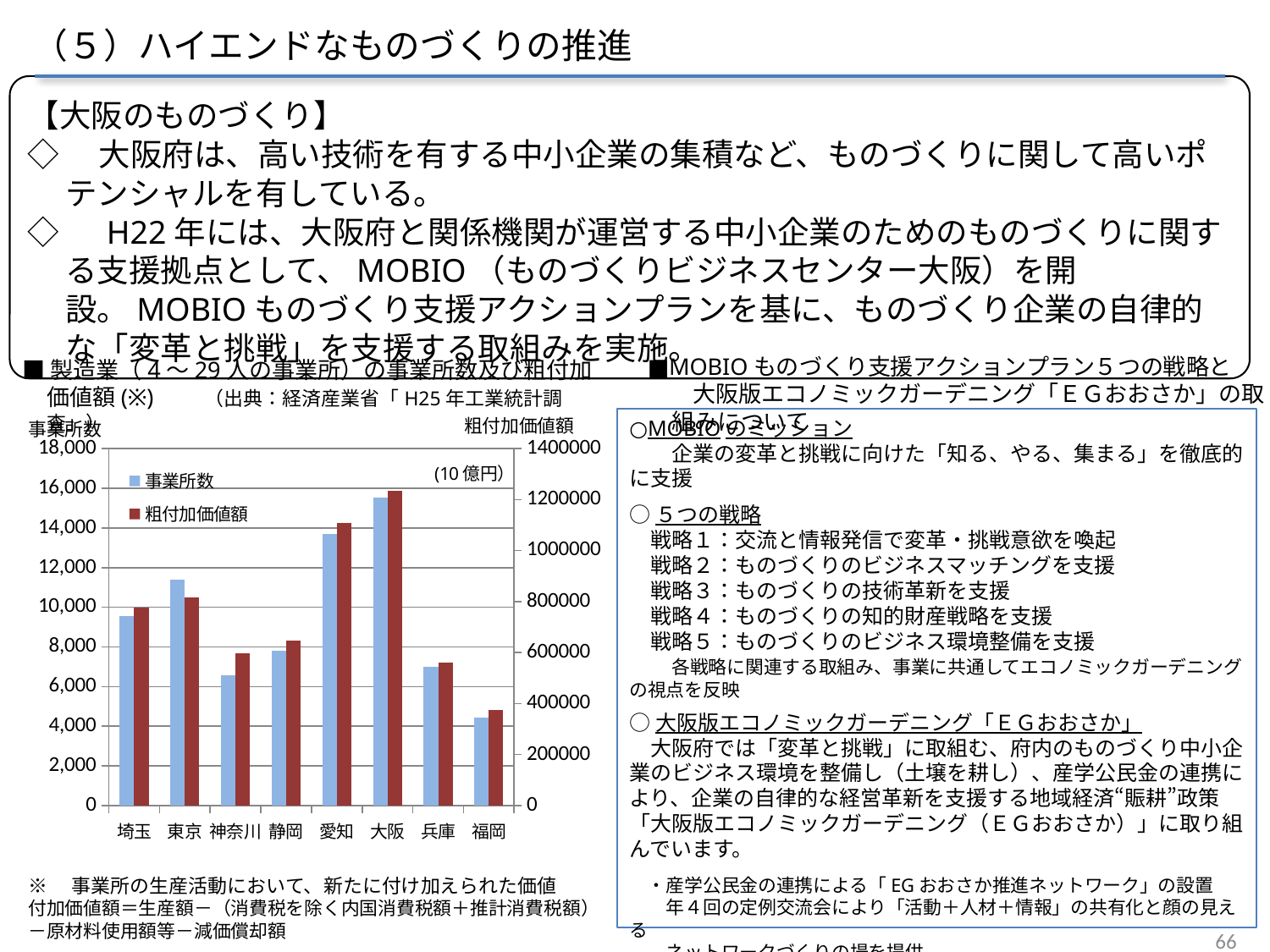
Is the 事業所数 value for 神奈川 greater or less than 8,000? less Which prefecture has the lowest 粗付加価値額 in the chart? 福岡 Which has the larger 事業所数, 東京 or 埼玉? 東京 Is the 事業所数 value for 東京 greater or less than 10,000? greater Which prefecture has the highest 粗付加価値額 in the chart? 大阪 What kind of chart is shown on the slide? bar chart Which prefecture has the highest 事業所数 in the chart? 大阪 Is the 粗付加価値額 value for 愛知 greater or less than 1000000? greater Which prefecture has the lowest 事業所数 in the chart? 福岡 How many series does the chart's legend list? 2 What unit is shown for the 粗付加価値額 axis on the right of the chart? 10億円 How many prefectures are shown on the x axis of the chart? 8